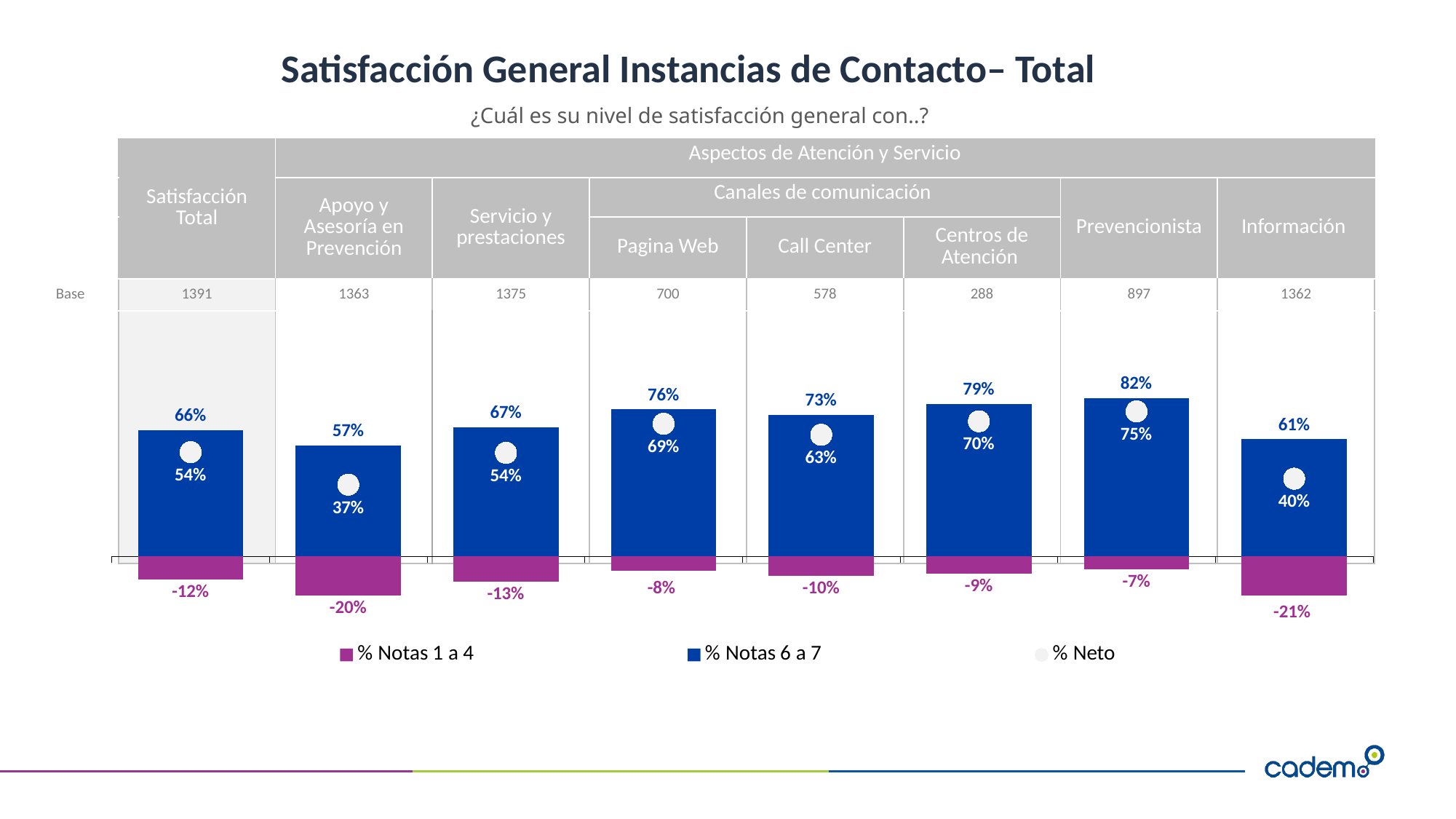
What is the % Neto value for Apoyo y Asesoría en Prevención? 37% Which category has the lowest % Neto value? Apoyo y Asesoría en Prevención Which legend entry is shown in purple? % Notas 1 a 4 What is the difference between the % Notas 6 a 7 values for Pagina Web and Call Center? 3% How many categories are shown on the x axis of the chart? 8 Which category has the highest % Notas 6 a 7 value? Prevencionista How many series does the legend list? 3 What is the % Notas 1 a 4 value for Información? -21% What is the % Notas 6 a 7 value for Prevencionista? 82% What kind of chart is shown on the slide? Bar chart Which has a higher % Neto value, Centros de Atención or Servicio y prestaciones? Centros de Atención What is the Base value shown for Call Center? 578